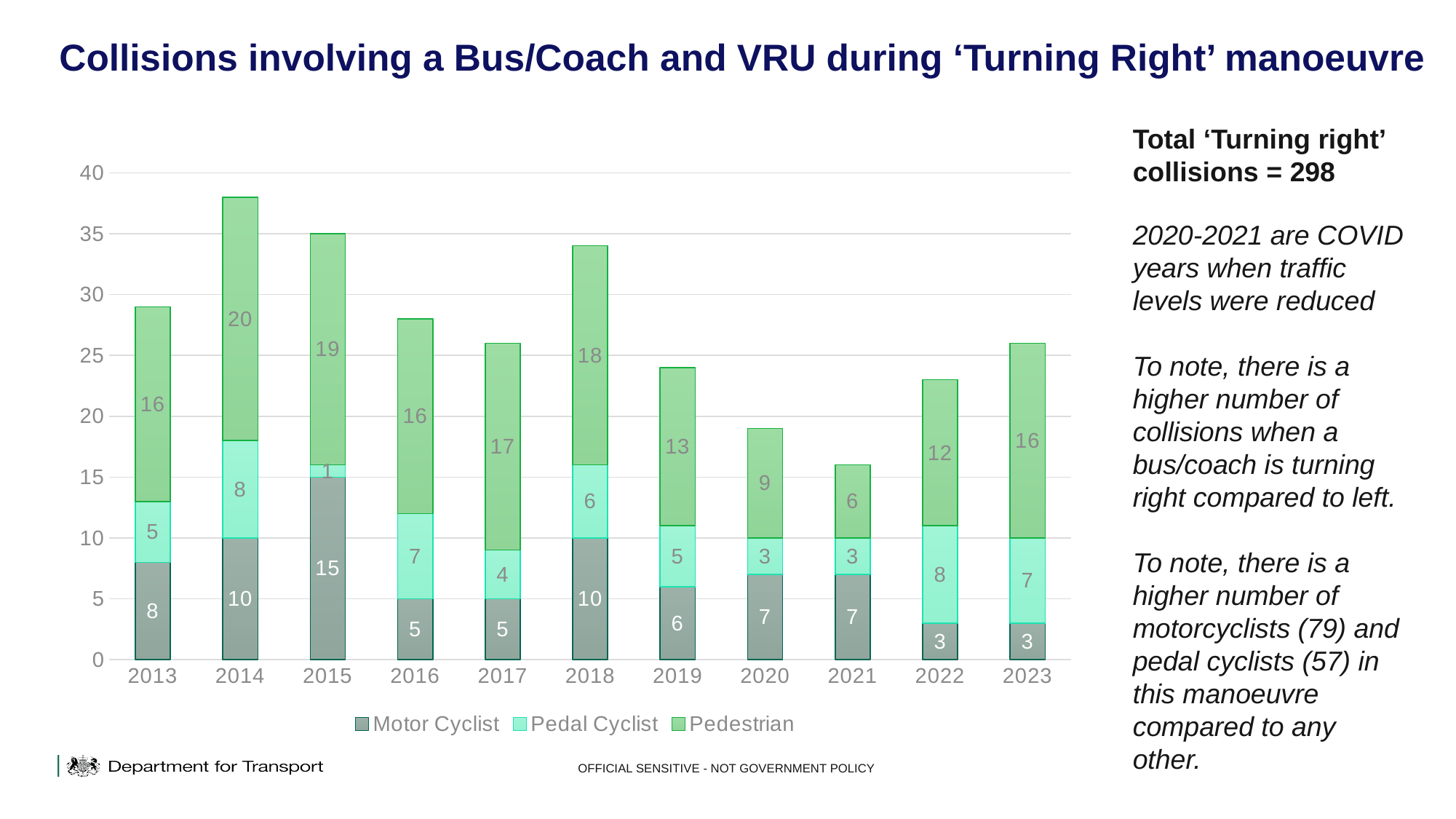
Which is larger, the Motor Cyclist value for 2018 or the Motor Cyclist value for 2019? 2018 What is the Pedal Cyclist value for 2022? 8 What is the Pedestrian value for 2014? 20 How many years are shown on the x axis? 11 Which year has the highest Pedestrian value? 2014 Which year has the lowest Pedal Cyclist value? 2015 What is the total of the stacked bar for 2014? 38 What is the Motor Cyclist value for 2015? 15 What is the difference between the Pedestrian values for 2018 and 2021? 12 What kind of chart is shown on the slide? Stacked bar chart How many series does the legend list? 3 What is the total of the stacked bar for 2021? 16